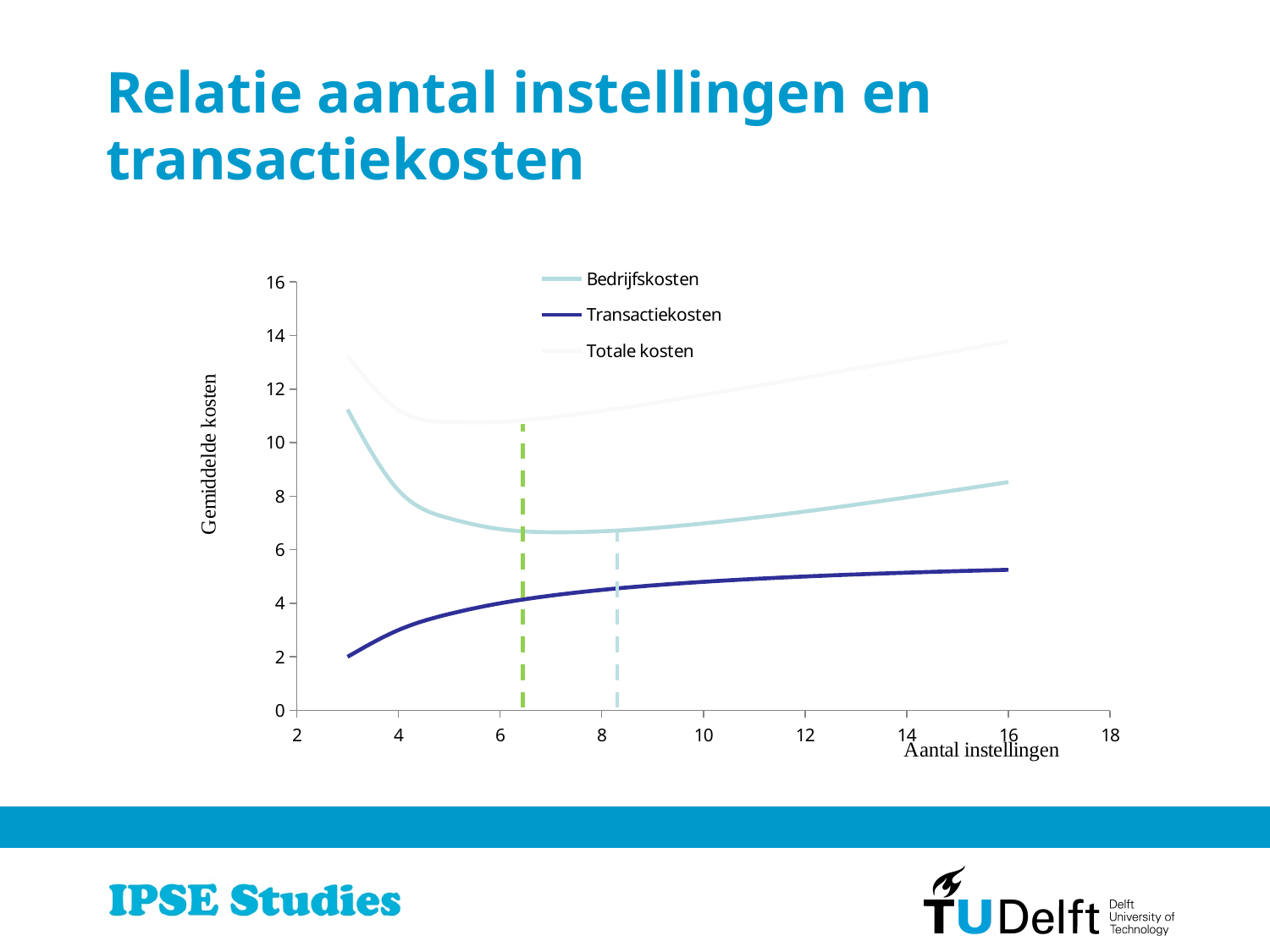
What is the label of the vertical axis? Gemiddelde kosten How many series does the legend list? 3 At 3 instellingen, which is larger: Transactiekosten or Totale kosten? Totale kosten At 16 instellingen, which is larger: Bedrijfskosten or Transactiekosten? Bedrijfskosten Is the Bedrijfskosten value at 3 instellingen greater or less than 10? greater Which series are listed in the legend? Bedrijfskosten, Transactiekosten, Totale kosten Is the Totale kosten value at 16 instellingen greater or less than 12? greater Is the Bedrijfskosten value at 16 instellingen greater or less than 10? less What kind of chart is shown on the slide? line chart Do the Transactiekosten values rise or fall as Aantal instellingen increases? rise Which series has the lowest values across the whole range of the x axis? Transactiekosten